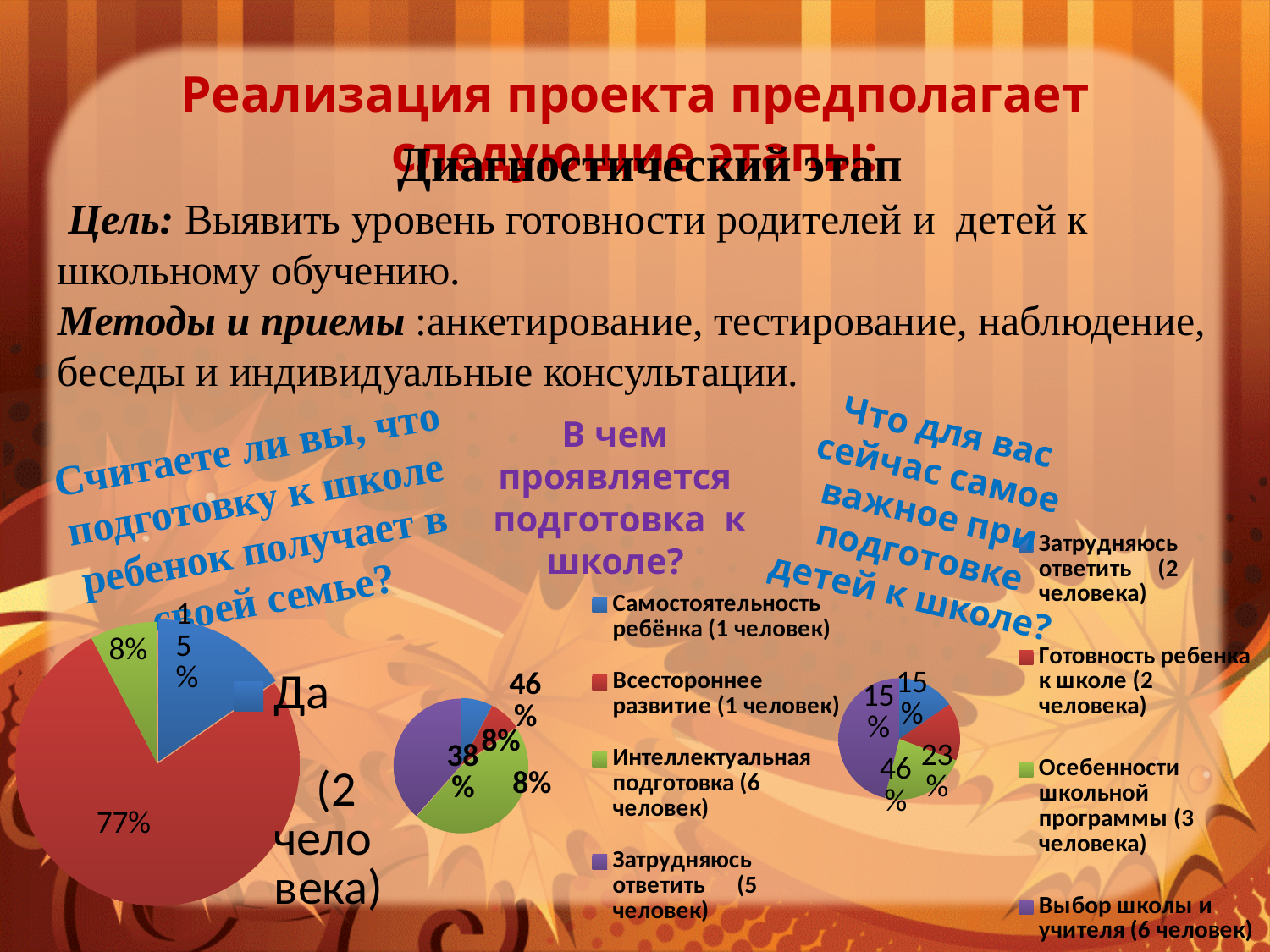
In the right chart ("Что для вас сейчас самое важное при подготовке детей к школе?"), which category has the largest slice? Выбор школы и учителя In the right chart ("Что для вас сейчас самое важное при подготовке детей к школе?"), how many people does the legend give for "Выбор школы и учителя"? 6 человек In the left chart ("Считаете ли вы, что подготовку к школе ребенок получает в своей семье?"), what is the share of the largest slice? 77% In the right chart ("Что для вас сейчас самое важное при подготовке детей к школе?"), what share does "Осебенности школьной программы" have? 23% How many entries does the legend of the middle chart ("В чем проявляется подготовка к школе?") list? 4 How many slices does the left chart ("Считаете ли вы, что подготовку к школе ребенок получает в своей семье?") have? 3 In the right chart ("Что для вас сейчас самое важное при подготовке детей к школе?"), what share does "Выбор школы и учителя" have? 46% In the middle chart ("В чем проявляется подготовка к школе?"), which is larger: "Интеллектуальная подготовка" or "Затрудняюсь ответить"? Интеллектуальная подготовка In the middle chart ("В чем проявляется подготовка к школе?"), what share does "Интеллектуальная подготовка" have? 46% What kind of chart is the left chart titled "Считаете ли вы, что подготовку к школе ребенок получает в своей семье?"? Pie chart In the left chart ("Считаете ли вы, что подготовку к школе ребенок получает в своей семье?"), what is the share of the smallest slice? 8%